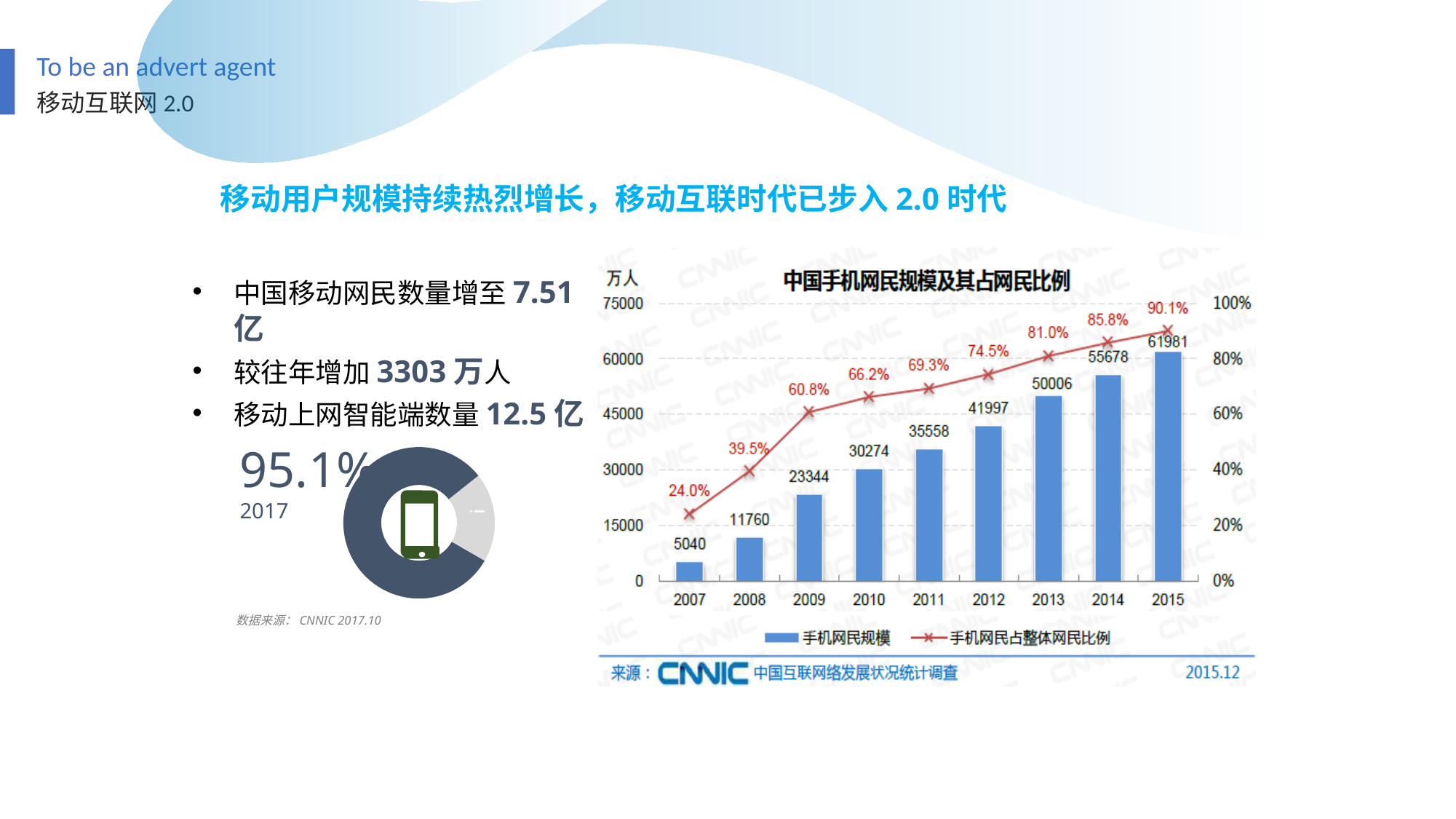
In the chart titled 中国手机网民规模及其占网民比例, how many series does the legend list? 2 In the chart titled 中国手机网民规模及其占网民比例, what is the value of 手机网民占整体网民比例 for 2009? 60.8% In the chart titled 中国手机网民规模及其占网民比例, does 手机网民规模 rise or fall from 2007 to 2015? rise In the chart titled 中国手机网民规模及其占网民比例, what is the value of 手机网民规模 for 2015? 61981 In the donut chart on the left of the slide, what percentage is shown for 2017? 95.1% In the chart titled 中国手机网民规模及其占网民比例, what is the difference in 手机网民规模 between 2015 and 2014? 6303 In the chart titled 中国手机网民规模及其占网民比例, which year has the highest 手机网民占整体网民比例? 2015 In the chart titled 中国手机网民规模及其占网民比例, what is the difference in 手机网民占整体网民比例 between 2008 and 2007? 15.5% In the chart titled 中国手机网民规模及其占网民比例, what is the value of 手机网民规模 for 2011? 35558 In the chart titled 中国手机网民规模及其占网民比例, which year has the lowest 手机网民规模? 2007 In the chart titled 中国手机网民规模及其占网民比例, how many years are shown on the x axis? 9 In the chart titled 中国手机网民规模及其占网民比例, which is larger: 手机网民规模 in 2012 or in 2013? 2013